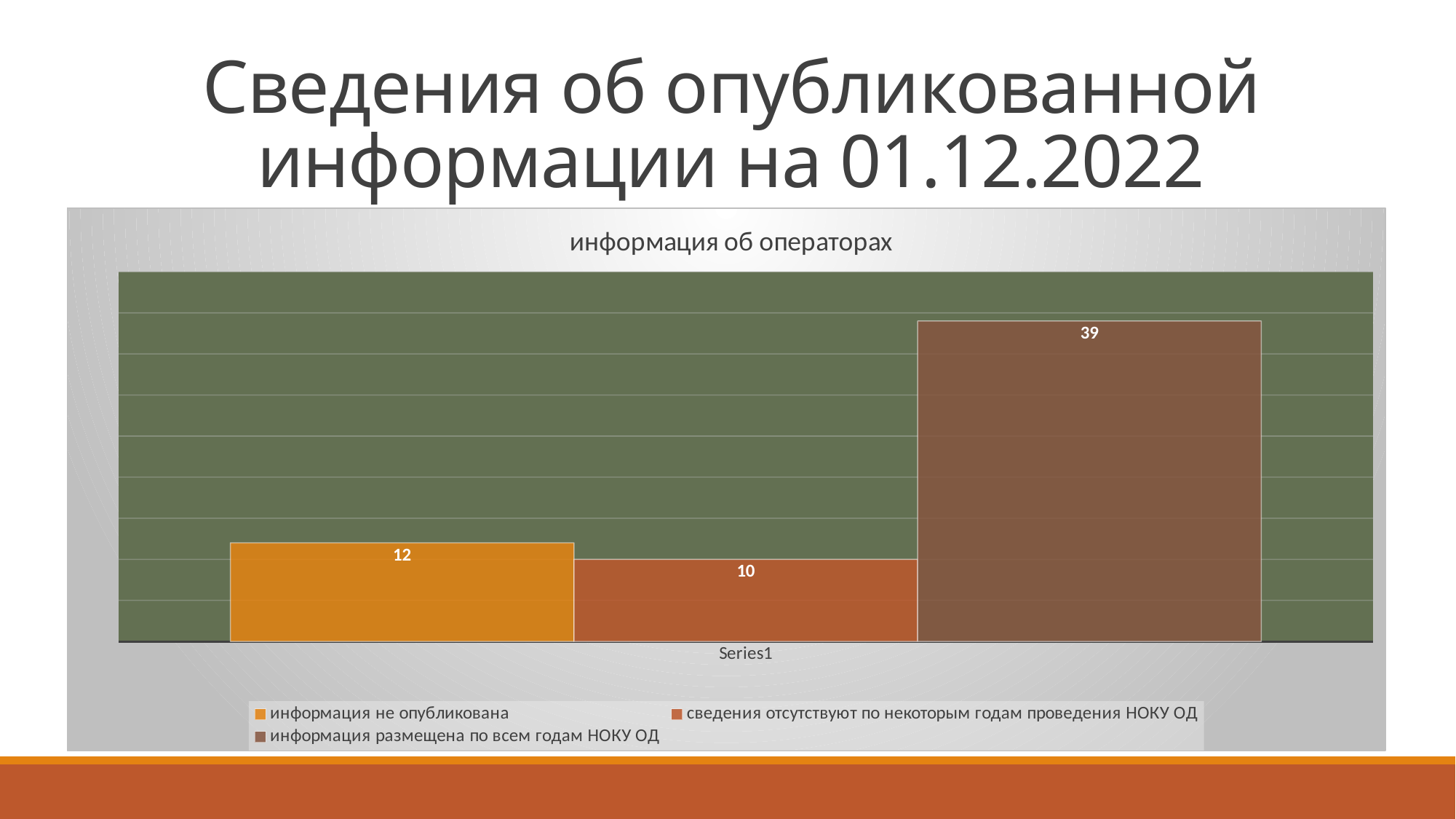
Which series has the highest value? информация размещена по всем годам НОКУ ОД Which series has the lowest value? сведения отсутствуют по некоторым годам проведения НОКУ ОД What is the title of the chart? информация об операторах What is the value for "информация не опубликована"? 12 Which is larger: the value for "информация не опубликована" or the value for "сведения отсутствуют по некоторым годам проведения НОКУ ОД"? информация не опубликована What is the label on the category axis of the chart? Series1 What is the value for "сведения отсутствуют по некоторым годам проведения НОКУ ОД"? 10 What is the value for "информация размещена по всем годам НОКУ ОД"? 39 How many series does the legend list? 3 What is the difference between the values for "информация не опубликована" and "сведения отсутствуют по некоторым годам проведения НОКУ ОД"? 2 What kind of chart is shown on the slide? bar chart What is the difference between the values for "информация размещена по всем годам НОКУ ОД" and "информация не опубликована"? 27